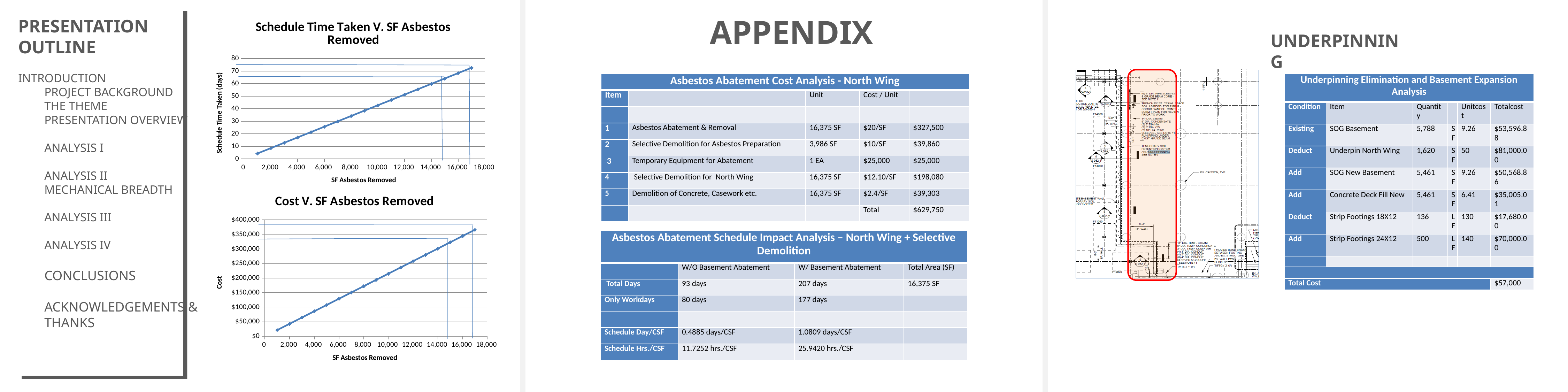
What kind of chart is "Cost V. SF Asbestos Removed"? line chart How many charts are shown on the Presentation Outline slide? 2 In the "Cost V. SF Asbestos Removed" chart, is the cost at 4,000 SF greater or less than $100,000? less In the "Schedule Time Taken V. SF Asbestos Removed" chart, is the schedule time at 16,000 SF greater or less than 60 days? greater In the "Schedule Time Taken V. SF Asbestos Removed" chart, do the values rise or fall as SF Asbestos Removed increases? rise In the "Schedule Time Taken V. SF Asbestos Removed" chart, is the schedule time at 8,000 SF greater or less than 30 days? greater What is the x-axis title of the "Cost V. SF Asbestos Removed" chart? SF Asbestos Removed In the "Cost V. SF Asbestos Removed" chart, does cost rise or fall as SF Asbestos Removed increases? rise What kind of chart is "Schedule Time Taken V. SF Asbestos Removed"? line chart What is the y-axis title of the "Schedule Time Taken V. SF Asbestos Removed" chart? Schedule Time Taken (days)